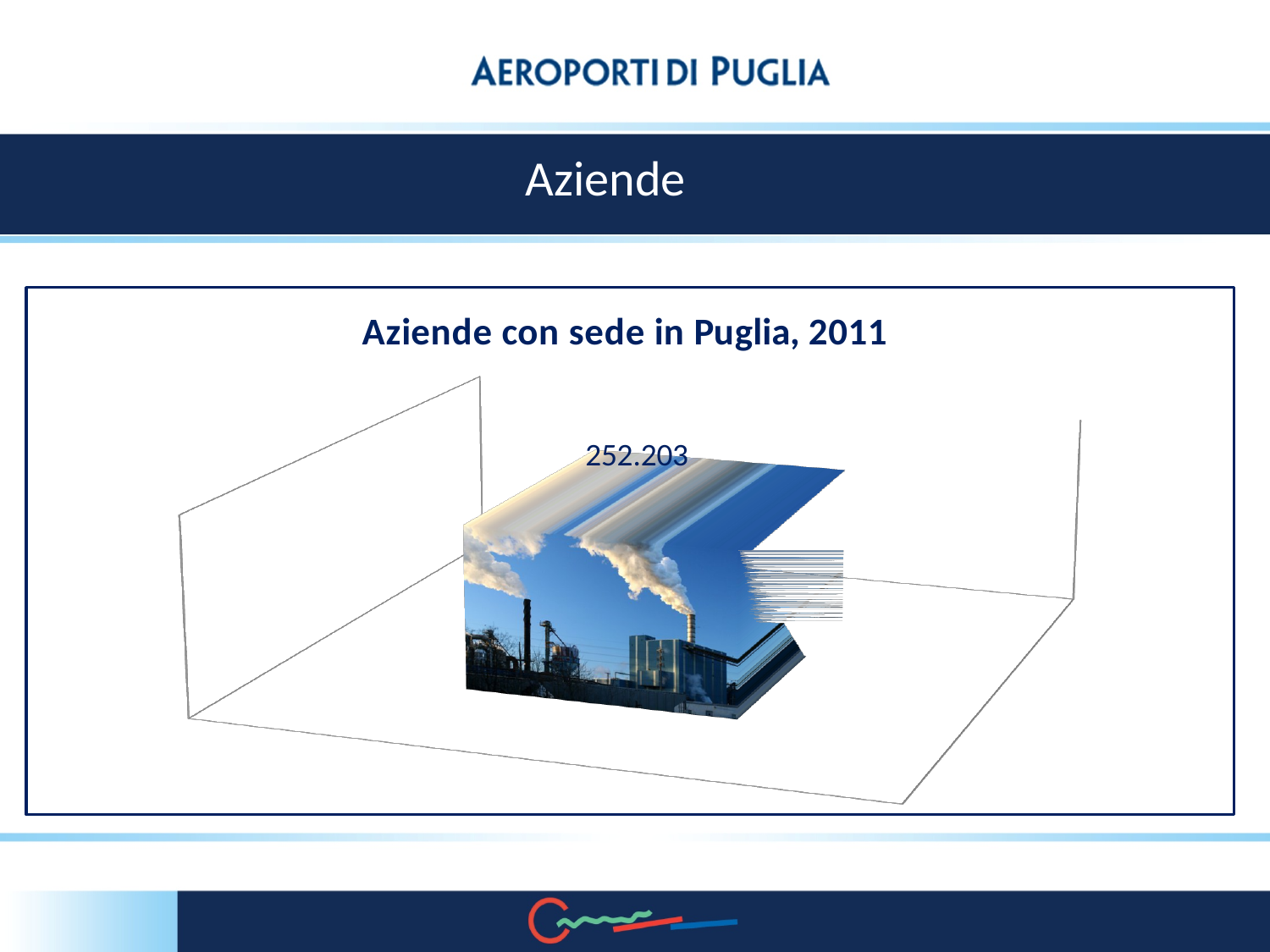
What is the title of the chart on the slide? Aziende con sede in Puglia, 2011 How many bars are plotted in the chart "Aziende con sede in Puglia, 2011"? 1 What kind of chart is "Aziende con sede in Puglia, 2011"? bar chart What value is shown by the data label on the bar in the chart "Aziende con sede in Puglia, 2011"? 252.203 What year does the chart title "Aziende con sede in Puglia" refer to? 2011